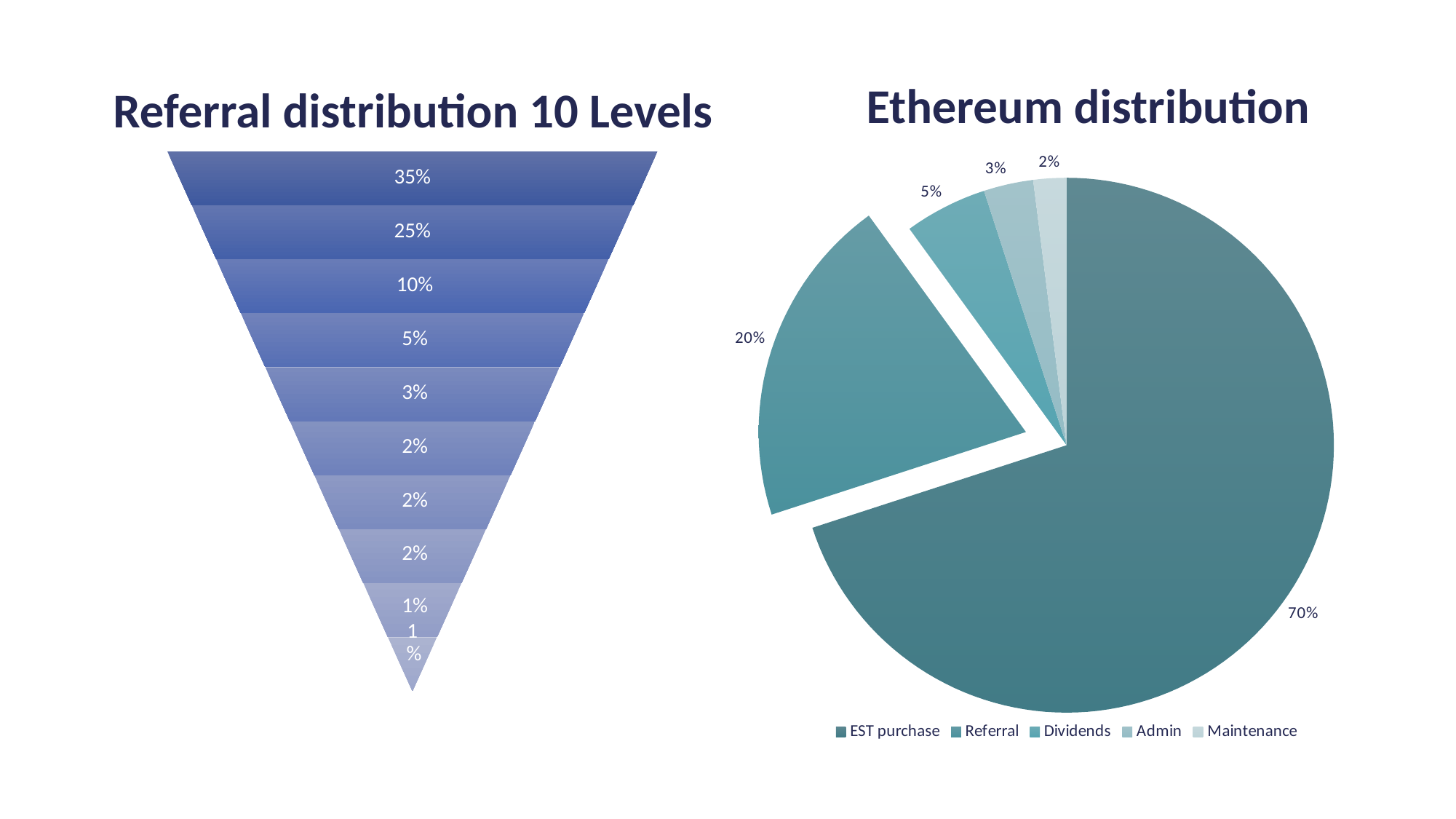
In the Referral distribution 10 Levels chart, what is the value of the top level? 35% In the Ethereum distribution chart, what share does EST purchase have? 70% In the Ethereum distribution chart, which category has the largest slice? EST purchase In the Ethereum distribution chart, how many categories does the legend list? 5 What kind of chart is the Ethereum distribution chart? Pie chart In the Referral distribution 10 Levels chart, how many levels are shown? 10 In the Ethereum distribution chart, which category has the smallest slice? Maintenance In the Referral distribution 10 Levels chart, do the values rise or fall from the top level to the bottom level? Fall In the Referral distribution 10 Levels chart, what is the value of the third level from the top? 10% In the Ethereum distribution chart, what share does Dividends have? 5% In the Ethereum distribution chart, what share does Referral have? 20% In the Ethereum distribution chart, what is the difference between the EST purchase and Referral shares? 50 percentage points